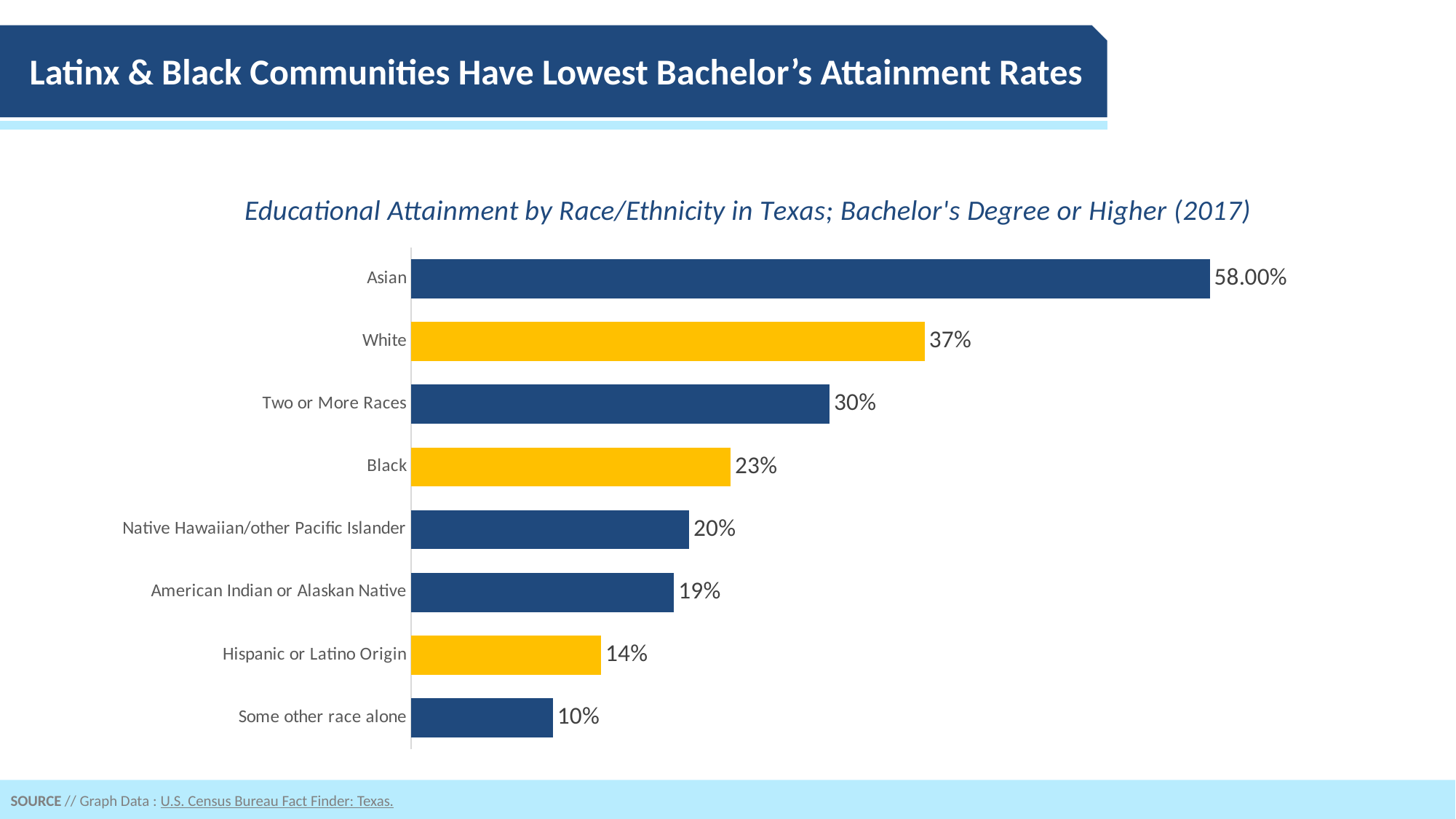
Which category has the lowest value? Some other race alone What is the value for Hispanic or Latino Origin? 14% What kind of chart is shown on the slide? Bar chart What is the difference between the values for White and Black? 14% Which category has the highest value? Asian What is the title of the chart? Educational Attainment by Race/Ethnicity in Texas; Bachelor's Degree or Higher (2017) What is the value for Black? 23% How many categories are shown in the chart? 8 What is the value for Asian? 58.00% What is the difference between the values for Two or More Races and Hispanic or Latino Origin? 16% Which is larger, the value for White or the value for Two or More Races? White What is the value for Native Hawaiian/other Pacific Islander? 20%